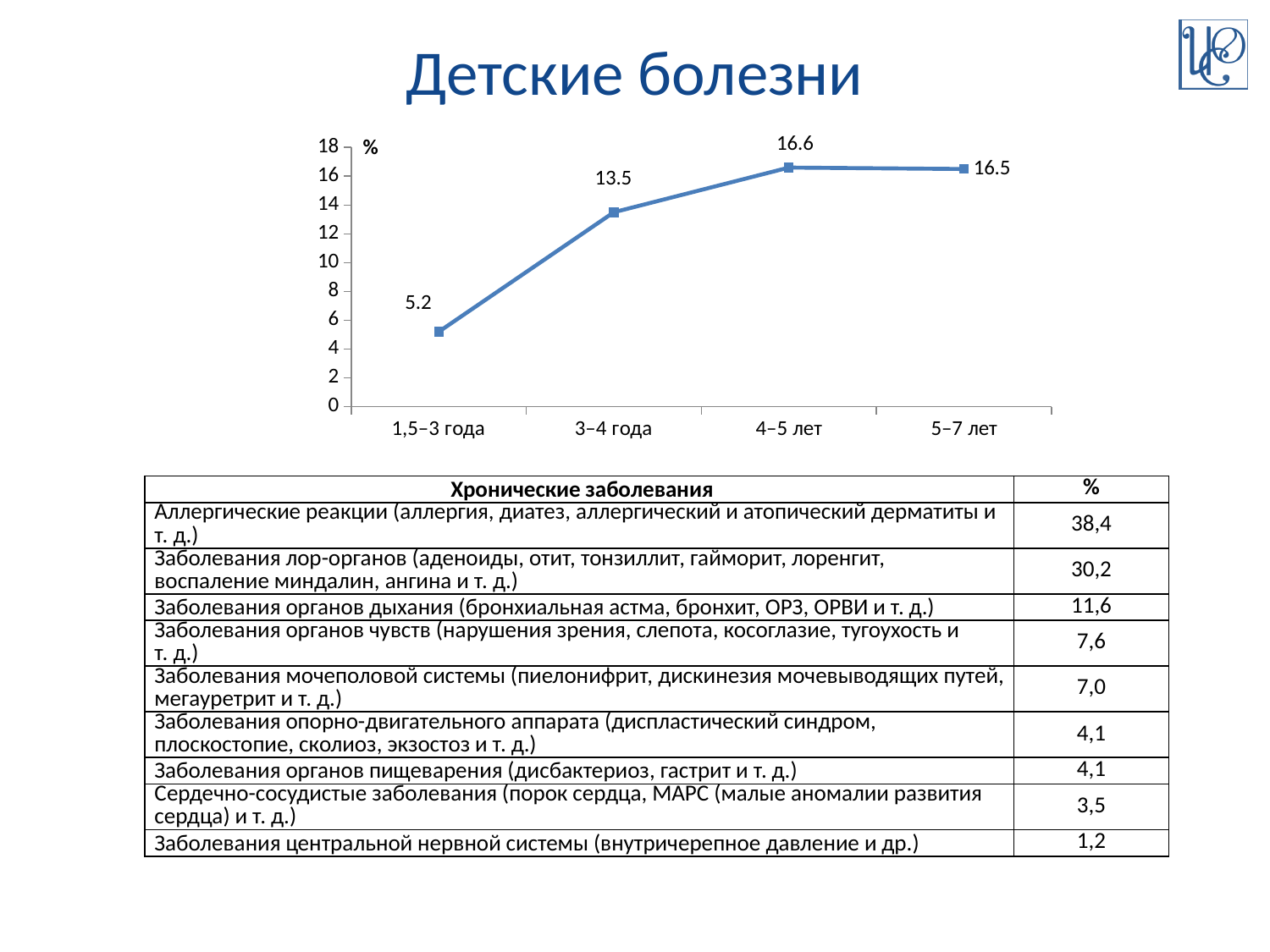
Is the value for 3–4 года greater or less than 10? greater What is the difference between the values for 3–4 года and 1,5–3 года? 8.3 What kind of chart is shown on the slide? line chart What unit is shown at the top of the vertical axis of the chart? % What is the value for the 3–4 года category? 13.5 What is the value for the 5–7 лет category? 16.5 Which age category has the lowest value? 1,5–3 года How many age categories are plotted on the chart? 4 Which age category has the highest value? 4–5 лет What is the difference between the values for 4–5 лет and 3–4 года? 3.1 What is the value for the 1,5–3 года category? 5.2 Which is larger, the value for 3–4 года or the value for 1,5–3 года? 3–4 года